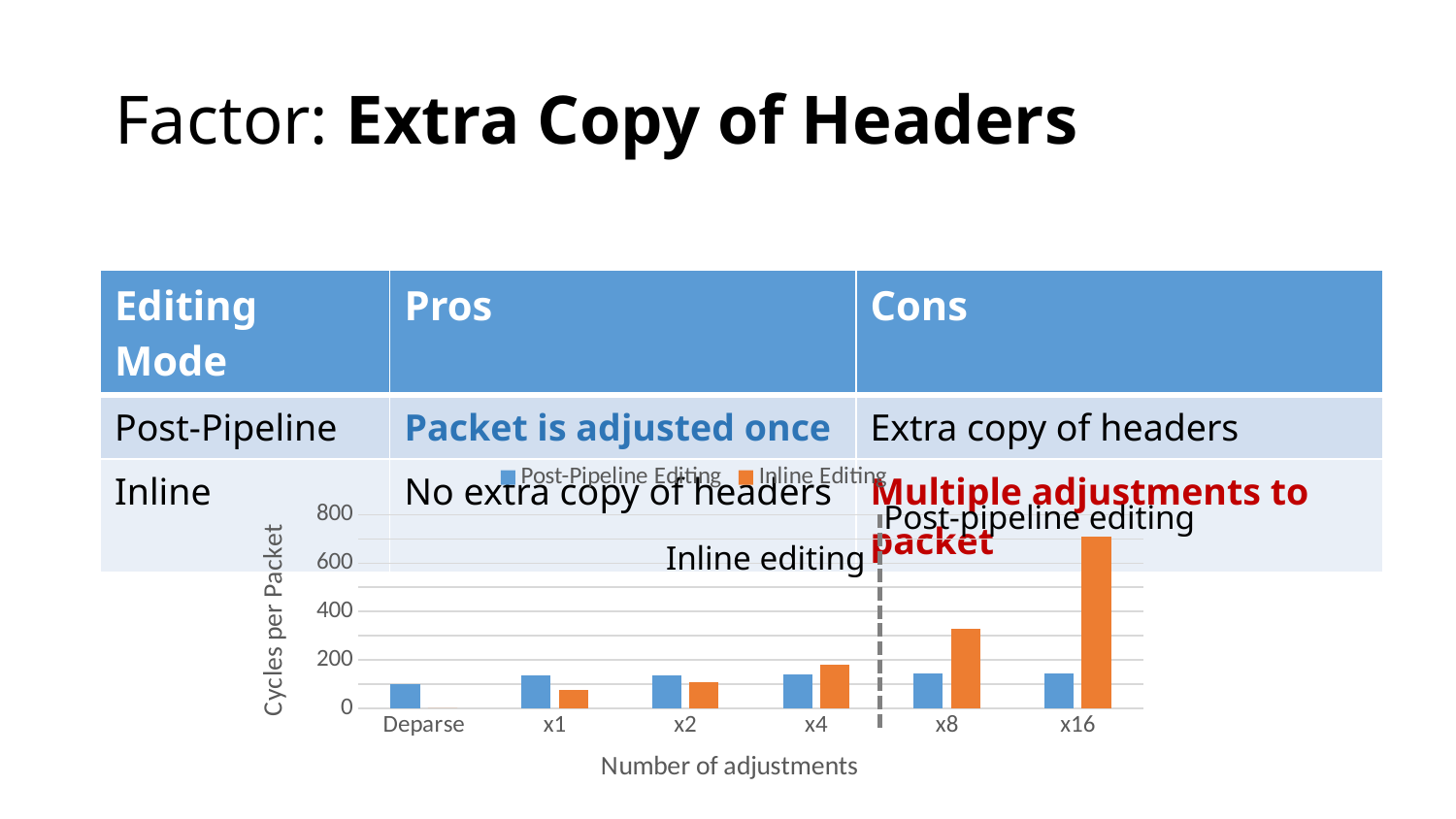
What is the label of the vertical axis of the chart? Cycles per Packet Is the Inline Editing value for x16 greater or less than 600? greater Is the Inline Editing value for x8 greater or less than 200? greater What is the label of the horizontal axis of the chart? Number of adjustments How many categories are shown on the x axis of the chart? 6 At x1, which series has the larger value, Post-Pipeline Editing or Inline Editing? Post-Pipeline Editing Is the Post-Pipeline Editing value for x16 greater or less than 200? less Do the Inline Editing values rise or fall from x1 to x16? rise At x8, which series has the larger value, Post-Pipeline Editing or Inline Editing? Inline Editing How many series does the chart legend list? 2 For which category is the Inline Editing value highest? x16 What kind of chart is shown on the slide? bar chart